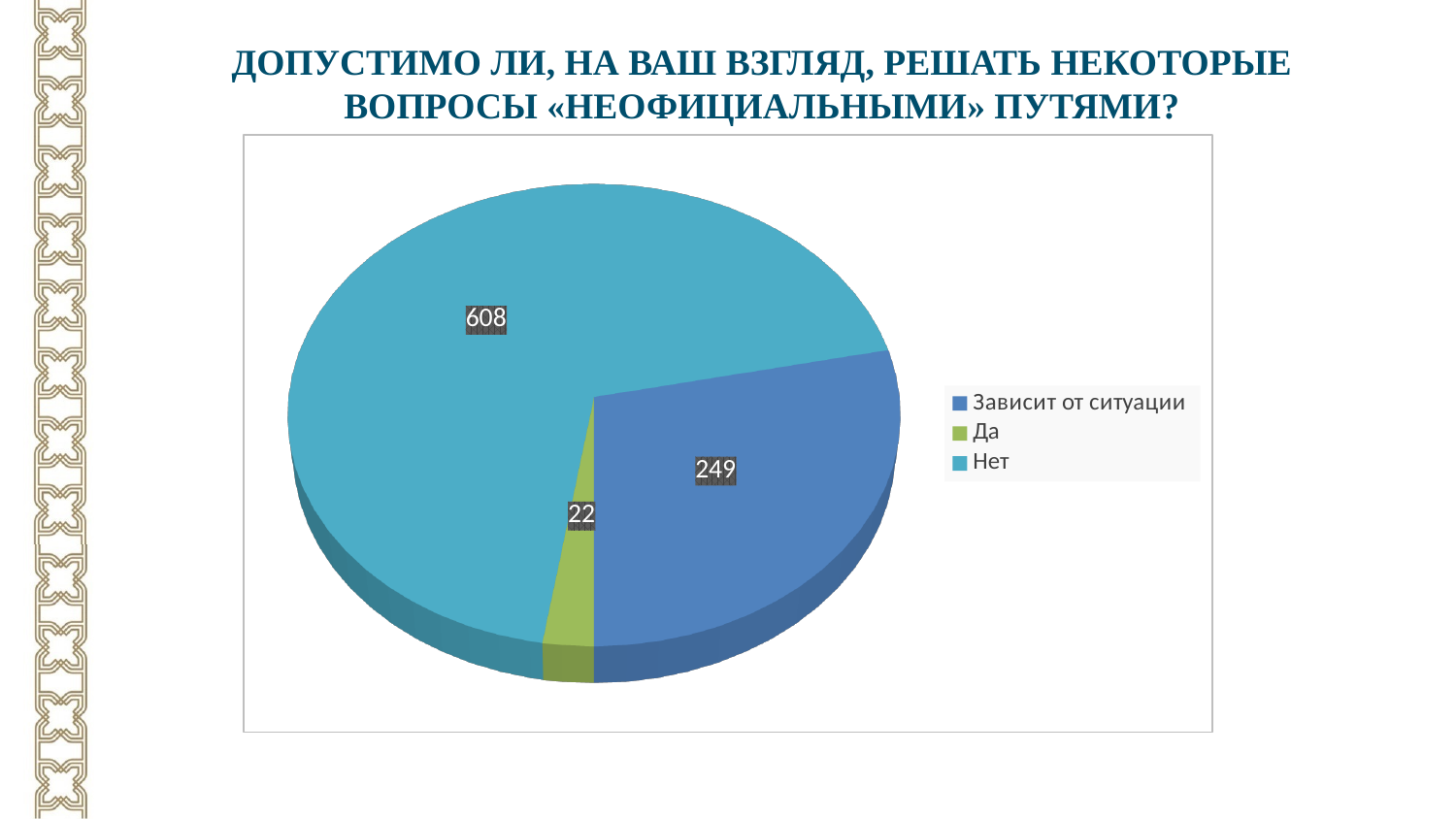
What is the difference between the values for "Нет" and "Зависит от ситуации"? 359 What is the value for the "Да" slice? 22 Which category has the largest slice? Нет Which category has the smallest slice? Да How many categories does the pie chart have? 3 What is the value for the "Зависит от ситуации" slice? 249 What is the total of all slices in the pie chart? 879 Which colour represents the "Да" category in the legend? green Which is larger, the value for "Зависит от ситуации" or the value for "Да"? Зависит от ситуации What is the difference between the values for "Зависит от ситуации" and "Да"? 227 What kind of chart is shown on the slide? pie chart What is the value for the "Нет" slice? 608